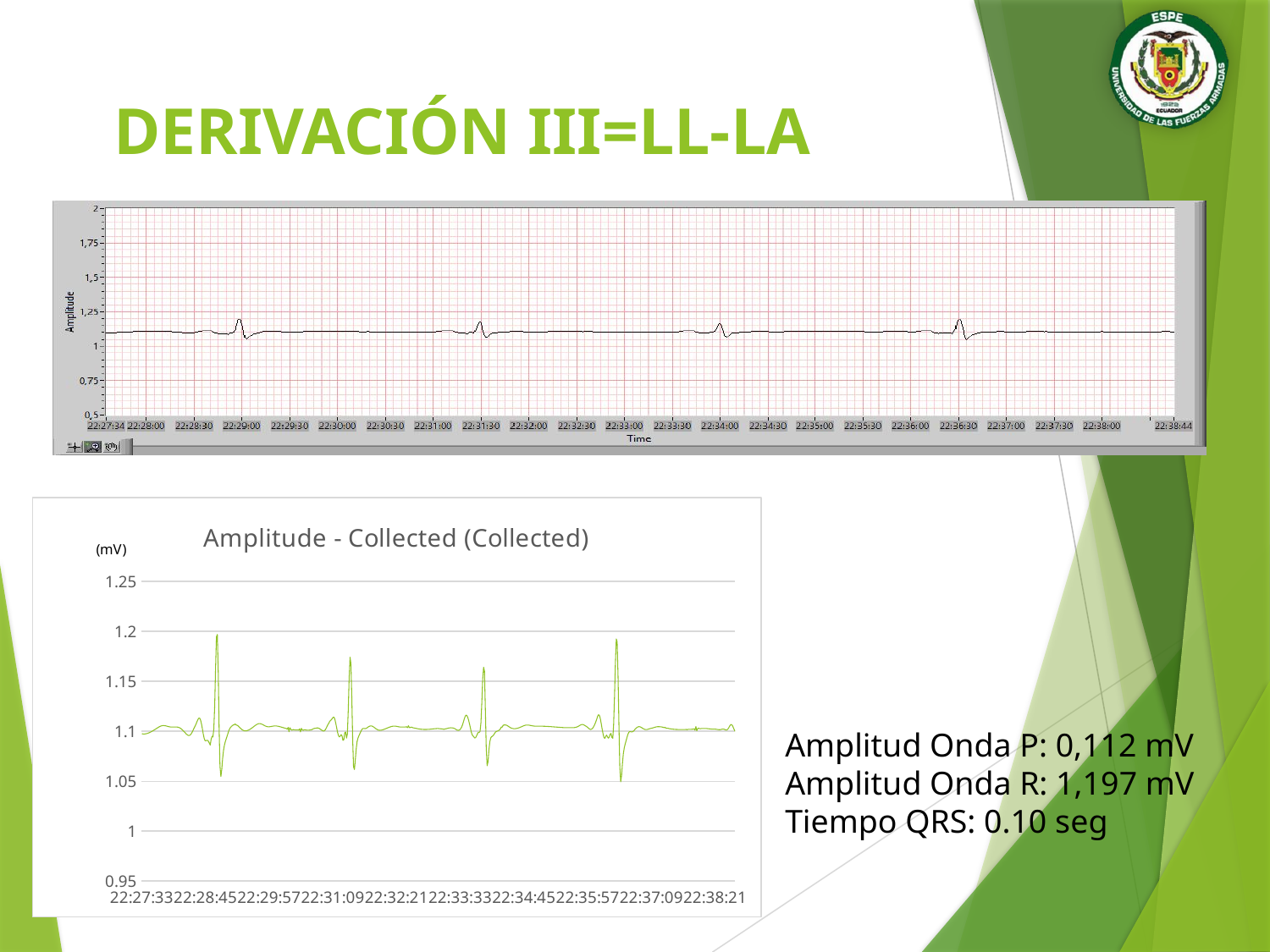
In the top chart, is the baseline of the trace greater or less than 1? greater What unit is shown on the y axis of the bottom chart? mV What is the title of the bottom chart? Amplitude - Collected (Collected) In the bottom chart, is the highest spike greater or less than 1.15? greater In the bottom chart, is the baseline level of the signal greater or less than 1.05? greater How many large spikes (R peaks) are visible in the bottom chart? 4 In the bottom chart, does the baseline of the signal rise, fall, or stay flat across the x axis? stays flat What is the lowest value shown on the y axis of the bottom chart? 0.95 What kind of chart is the bottom chart titled "Amplitude - Collected (Collected)"? Line chart In the top chart, how many heartbeat spikes are visible in the trace? 4